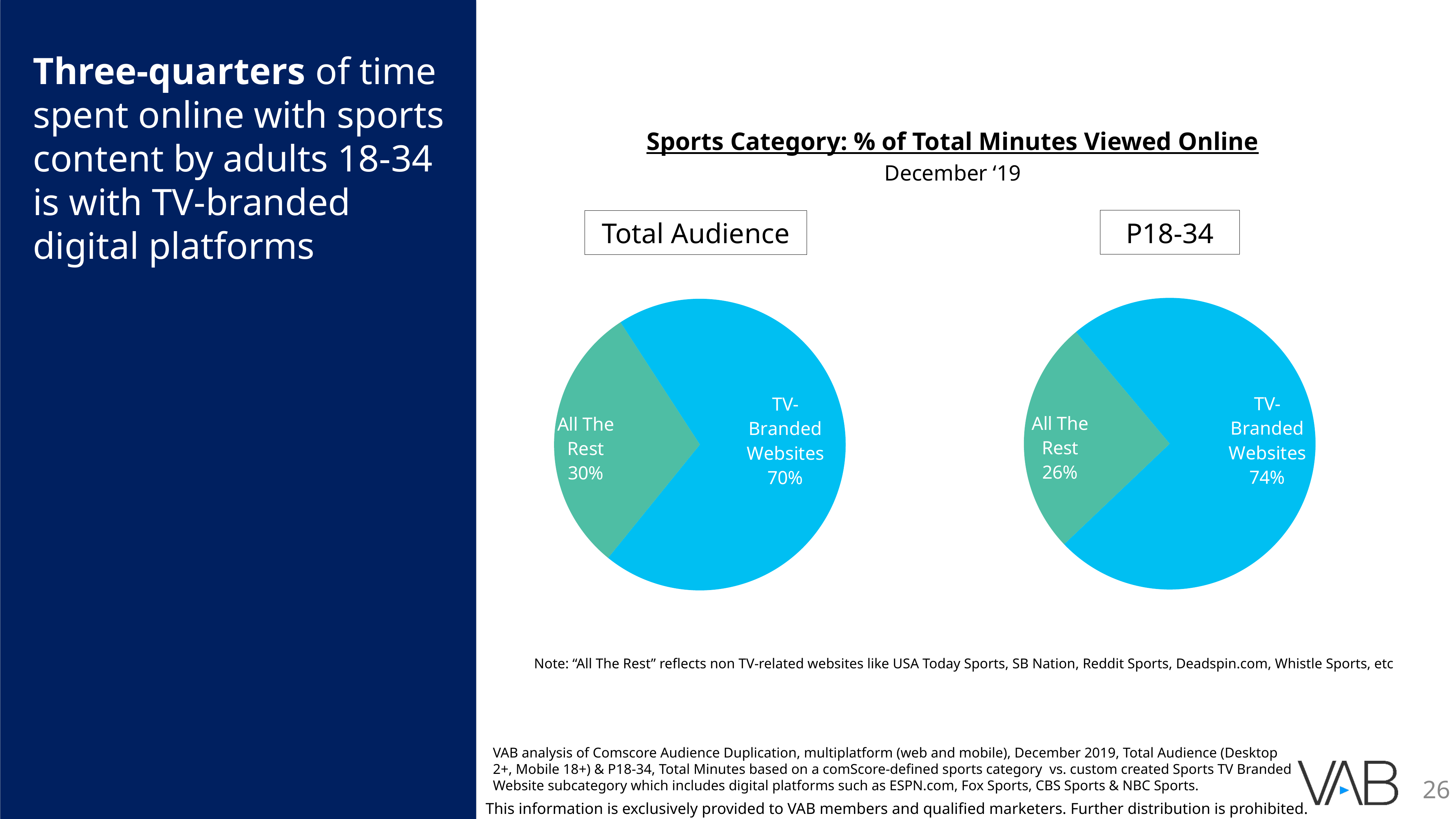
What is the difference between the TV-Branded Websites share in the P18-34 chart and in the Total Audience chart? 4 percentage points In the Total Audience pie chart, what share of total minutes viewed online is for TV-Branded Websites? 70% In the P18-34 pie chart, what share is labelled for All The Rest? 26% How many slices does the Total Audience pie chart have? 2 What is the title shown above the two pie charts? Sports Category: % of Total Minutes Viewed Online In the P18-34 pie chart, what share of total minutes viewed online is for TV-Branded Websites? 74% Is the All The Rest share larger in the Total Audience chart or the P18-34 chart? Total Audience In the Total Audience pie chart, what share is labelled for All The Rest? 30% What month and year do the pie charts cover? December '19 In the Total Audience pie chart, which slice is the smallest? All The Rest In the P18-34 pie chart, which slice is the largest? TV-Branded Websites What type of chart is used for the P18-34 data? Pie chart